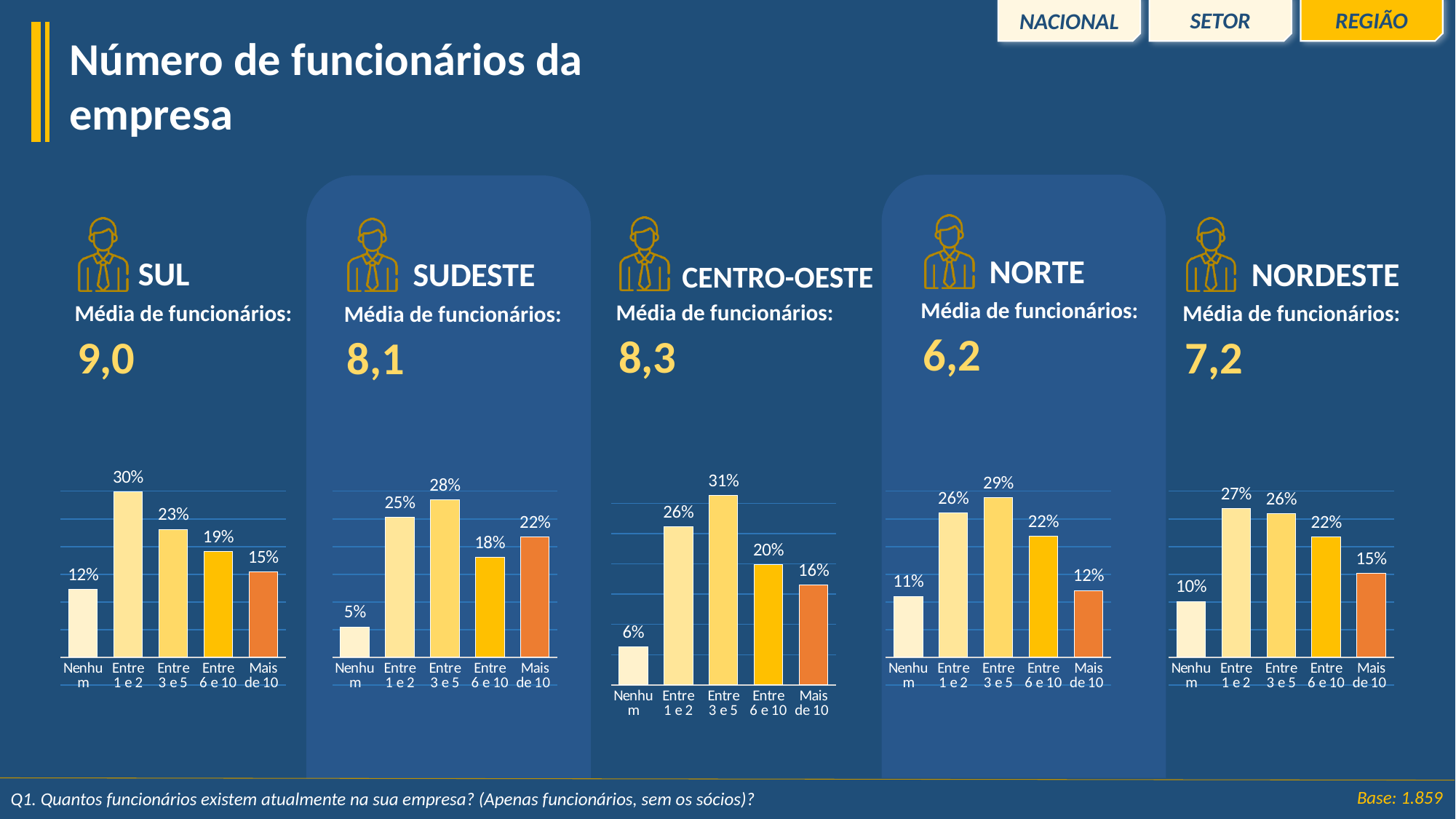
How many categories does the SUL chart show? 5 In the CENTRO-OESTE chart, which category has the highest value? Entre 3 e 5 In the SUL chart, what is the value for 'Entre 1 e 2'? 30% In the SUDESTE chart, which is larger: 'Entre 6 e 10' or 'Mais de 10'? Mais de 10 What is the 'Média de funcionários' shown for NORDESTE? 7,2 What kind of chart is used for the NORTE region? Bar chart In the NORTE chart, which category has the lowest value? Nenhum In the SUDESTE chart, what is the value for 'Nenhum'? 5% In the CENTRO-OESTE chart, what is the value for 'Mais de 10'? 16% In the NORDESTE chart, what is the difference between 'Entre 1 e 2' and 'Mais de 10'? 12% Which region shows the highest 'Média de funcionários' value? SUL In the NORTE chart, what is the difference between 'Entre 3 e 5' and 'Entre 6 e 10'? 7%